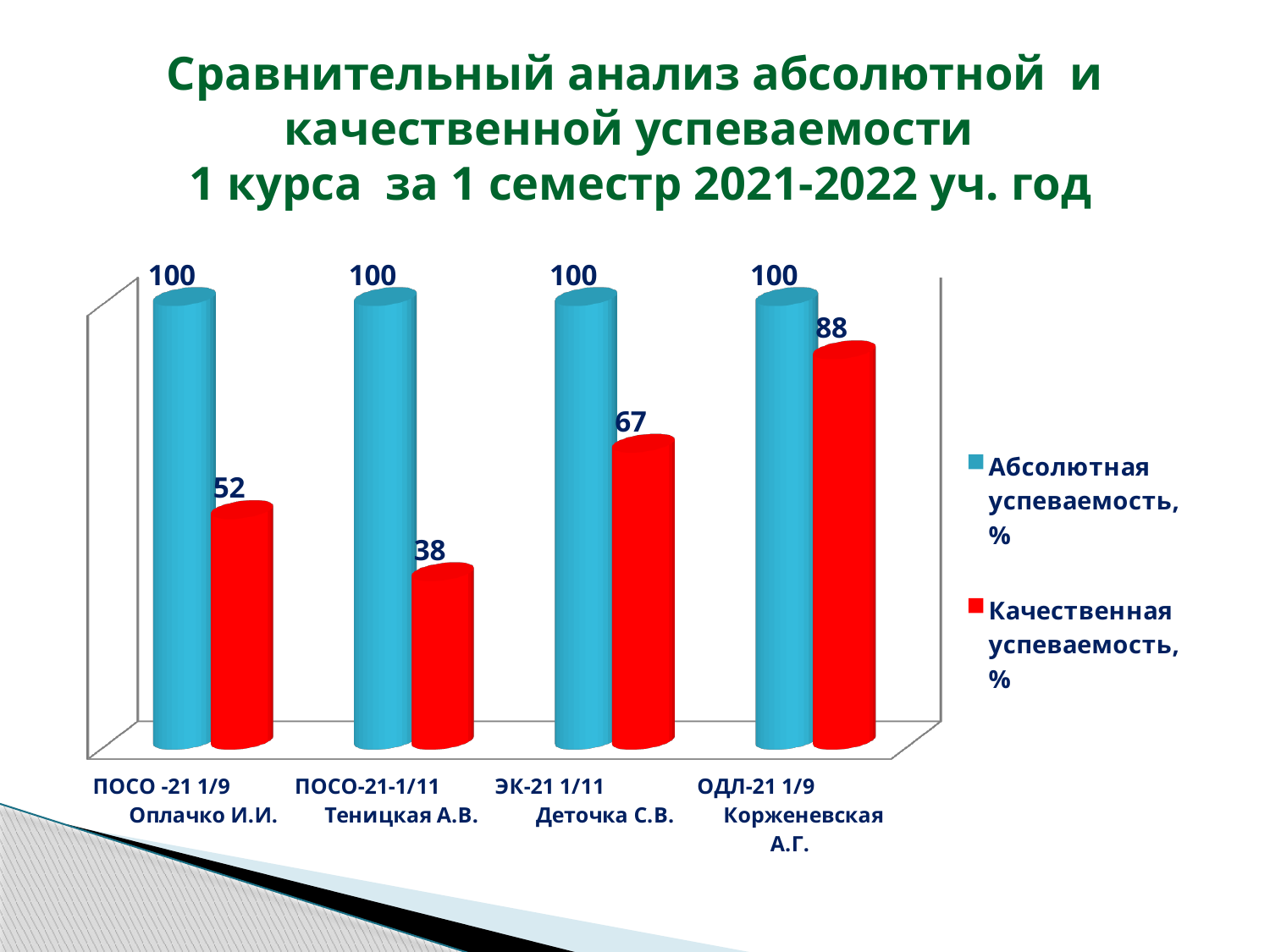
What is the value of Качественная успеваемость, % for ЭК-21 1/11 Деточка С.В.? 67 Which group has the highest Качественная успеваемость, %? ОДЛ-21 1/9 Корженевская А.Г. What is the value of Качественная успеваемость, % for ПОСО-21-1/11 Теницкая А.В.? 38 What is the value of Абсолютная успеваемость, % for ОДЛ-21 1/9 Корженевская А.Г.? 100 What kind of chart is shown on the slide? Bar chart Which is larger: Качественная успеваемость, % for ПОСО -21 1/9 Оплачко И.И. or for ЭК-21 1/11 Деточка С.В.? ЭК-21 1/11 Деточка С.В. How many series does the legend list? 2 What is the difference between Абсолютная успеваемость, % and Качественная успеваемость, % for ЭК-21 1/11 Деточка С.В.? 33 What is the value of Качественная успеваемость, % for ПОСО -21 1/9 Оплачко И.И.? 52 Which group has the lowest Качественная успеваемость, %? ПОСО-21-1/11 Теницкая А.В. What is the difference in Качественная успеваемость, % between ОДЛ-21 1/9 Корженевская А.Г. and ПОСО -21 1/9 Оплачко И.И.? 36 How many groups are shown on the x axis of the chart? 4